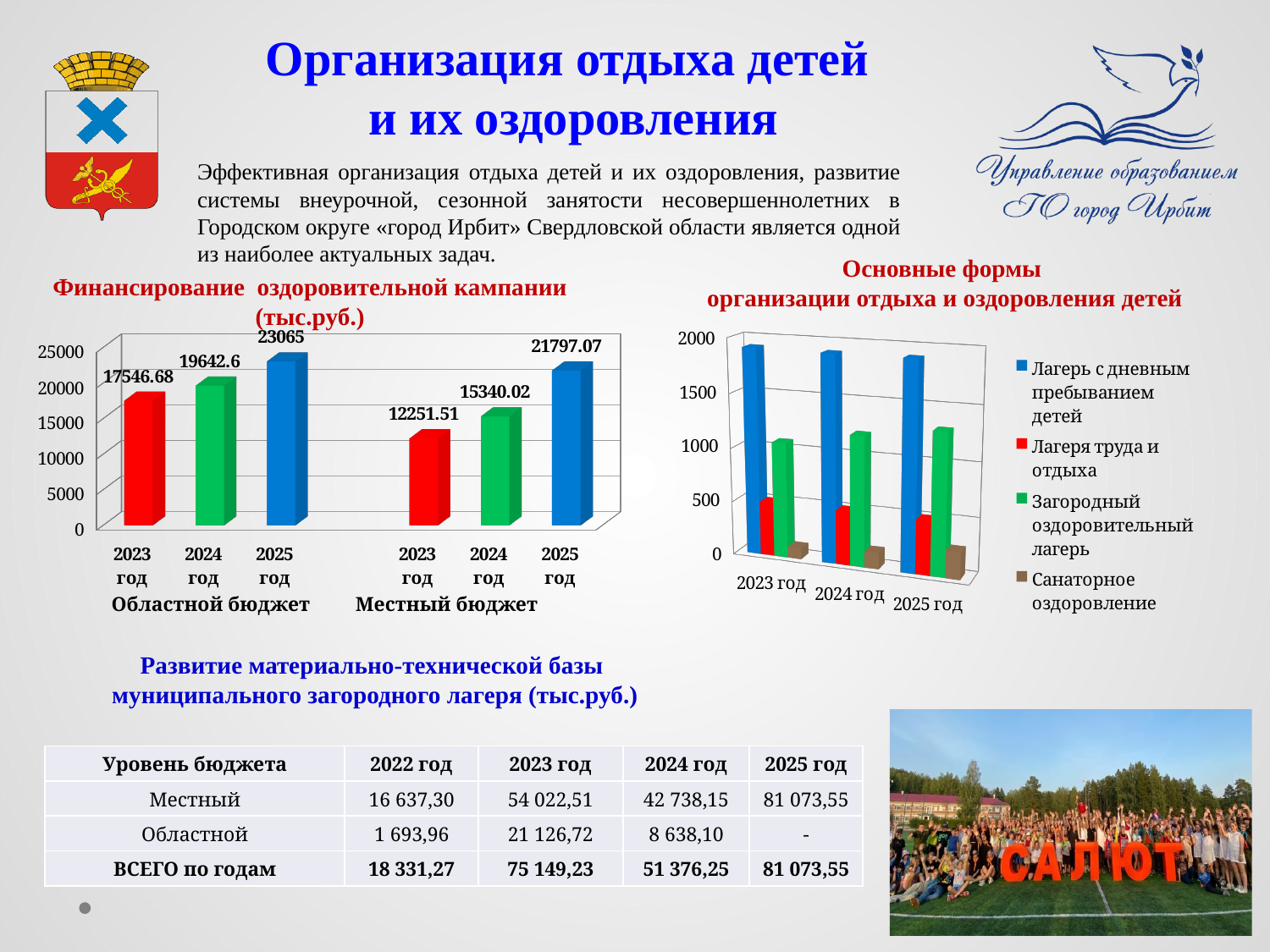
On the chart 'Финансирование оздоровительной кампании (тыс.руб.)', what is the difference between the 2025 год and 2023 год values in the Областной бюджет group? 5518.32 On the chart 'Основные формы организации отдыха и оздоровления детей', is the value for 'Санаторное оздоровление' in 2025 год greater or less than 500? less On the chart 'Финансирование оздоровительной кампании (тыс.руб.)', which bar has the highest value? 2025 год, Областной бюджет On the chart 'Финансирование оздоровительной кампании (тыс.руб.)', what is the value for 2023 год in the Местный бюджет group? 12251.51 On the chart 'Финансирование оздоровительной кампании (тыс.руб.)', what is the value for 2025 год in the Областной бюджет group? 23065 On the chart 'Финансирование оздоровительной кампании (тыс.руб.)', which is larger: the 2024 год value for Областной бюджет or the 2025 год value for Местный бюджет? 2025 год, Местный бюджет What kind of chart is 'Основные формы организации отдыха и оздоровления детей'? bar chart On the chart 'Финансирование оздоровительной кампании (тыс.руб.)', what is the value for 2024 год in the Местный бюджет group? 15340.02 On the chart 'Финансирование оздоровительной кампании (тыс.руб.)', do the values rise or fall from 2023 to 2025 in the Местный бюджет group? rise On the chart 'Основные формы организации отдыха и оздоровления детей', is the value for 'Лагерь с дневным пребыванием детей' in 2023 год greater or less than 1500? greater On the chart 'Финансирование оздоровительной кампании (тыс.руб.)', which bar has the lowest value? 2023 год, Местный бюджет On the chart 'Основные формы организации отдыха и оздоровления детей', how many series does the legend list? 4